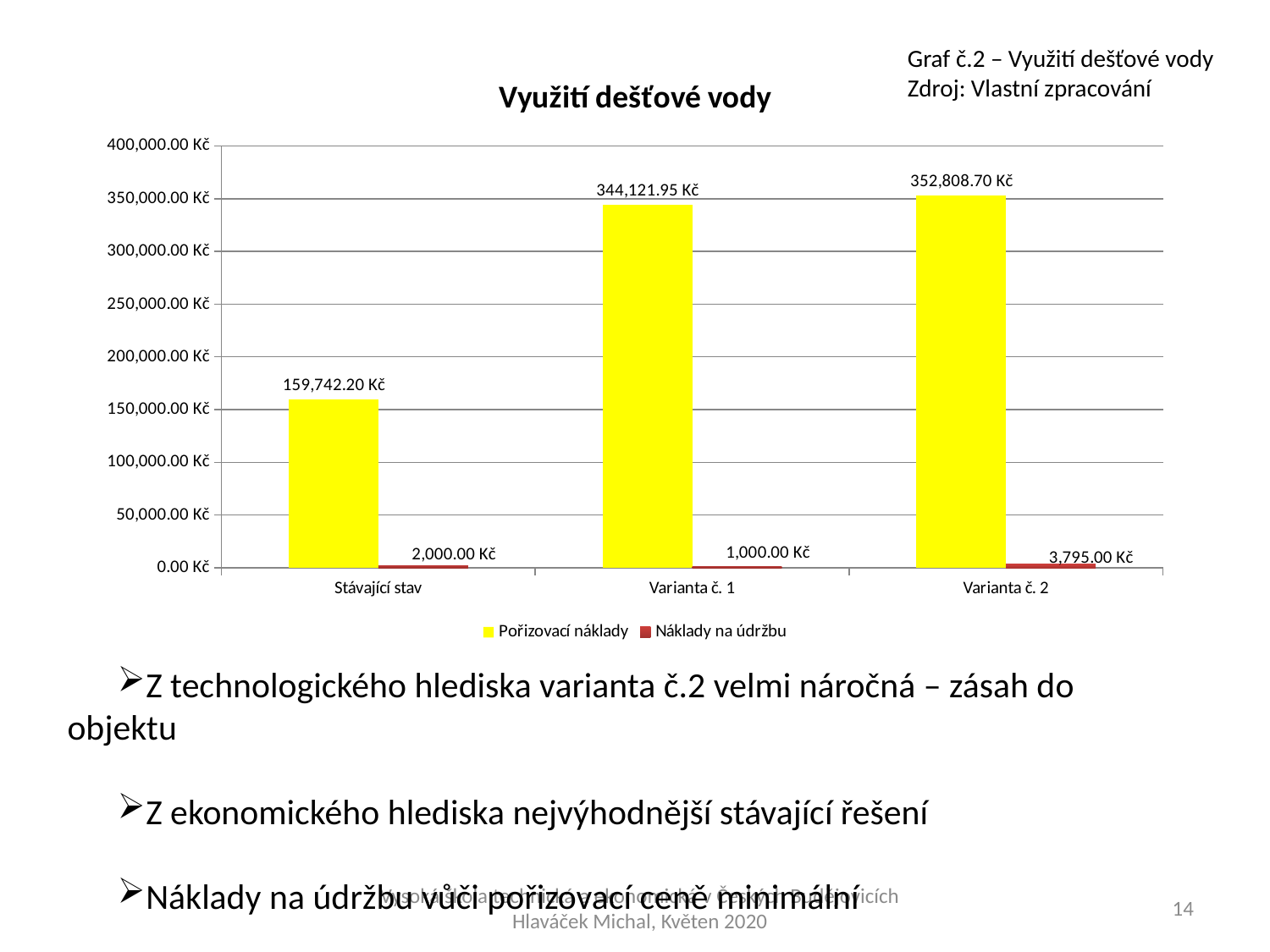
Which colour represents Náklady na údržbu in the chart? red What is the value of Náklady na údržbu for Varianta č. 2? 3,795.00 Kč What is the title of the chart? Využití dešťové vody What is the value of Pořizovací náklady for Stávající stav? 159,742.20 Kč Which is larger: Náklady na údržbu for Stávající stav or for Varianta č. 1? Stávající stav What is the value of Pořizovací náklady for Varianta č. 1? 344,121.95 Kč How many categories are shown on the x axis? 3 How many series does the legend list? 2 What type of chart is shown on the slide? bar chart Which category has the lowest Náklady na údržbu? Varianta č. 1 Which category has the highest Pořizovací náklady? Varianta č. 2 What is the difference in Pořizovací náklady between Varianta č. 2 and Varianta č. 1? 8,686.75 Kč